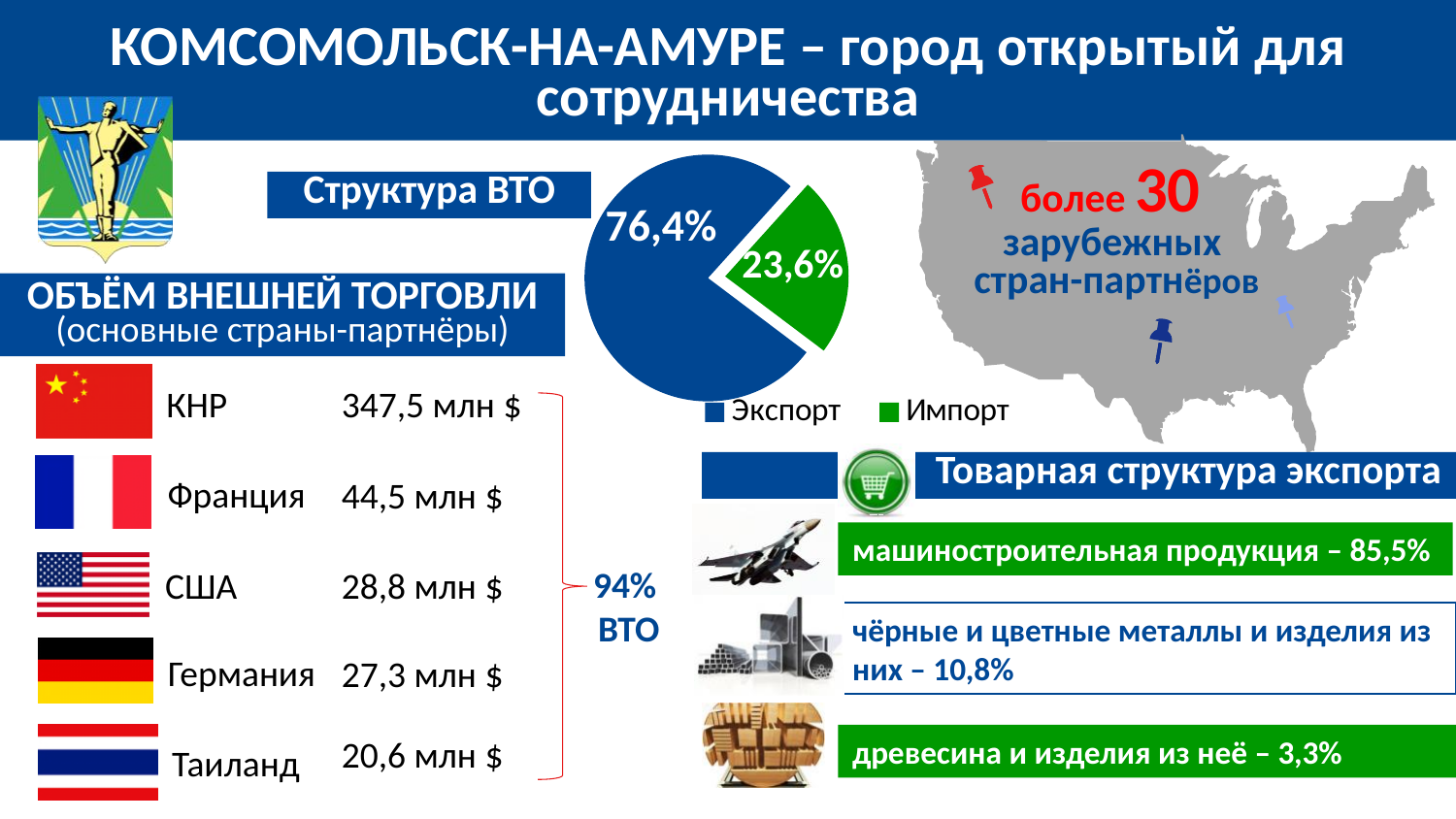
In the "Структура ВТО" pie chart, what share is labelled for Экспорт? 76,4% How many slices does the "Структура ВТО" pie chart have? 2 In the "Структура ВТО" pie chart, by how many percentage points does Экспорт exceed Импорт? 52,8 Which slice of the "Структура ВТО" pie chart is the largest? Экспорт In the "Структура ВТО" pie chart, what share is labelled for Импорт? 23,6% What colour is the Экспорт slice in the "Структура ВТО" pie chart? blue What share of the "Структура ВТО" pie does the Импорт slice represent? 23,6% In the "Структура ВТО" pie chart, which is larger, Экспорт or Импорт? Экспорт Which slice of the "Структура ВТО" pie chart is the smallest? Импорт How many entries does the legend of the "Структура ВТО" pie chart list? 2 What kind of chart is shown under the heading "Структура ВТО"? pie chart What colour is the Импорт slice in the "Структура ВТО" pie chart? green